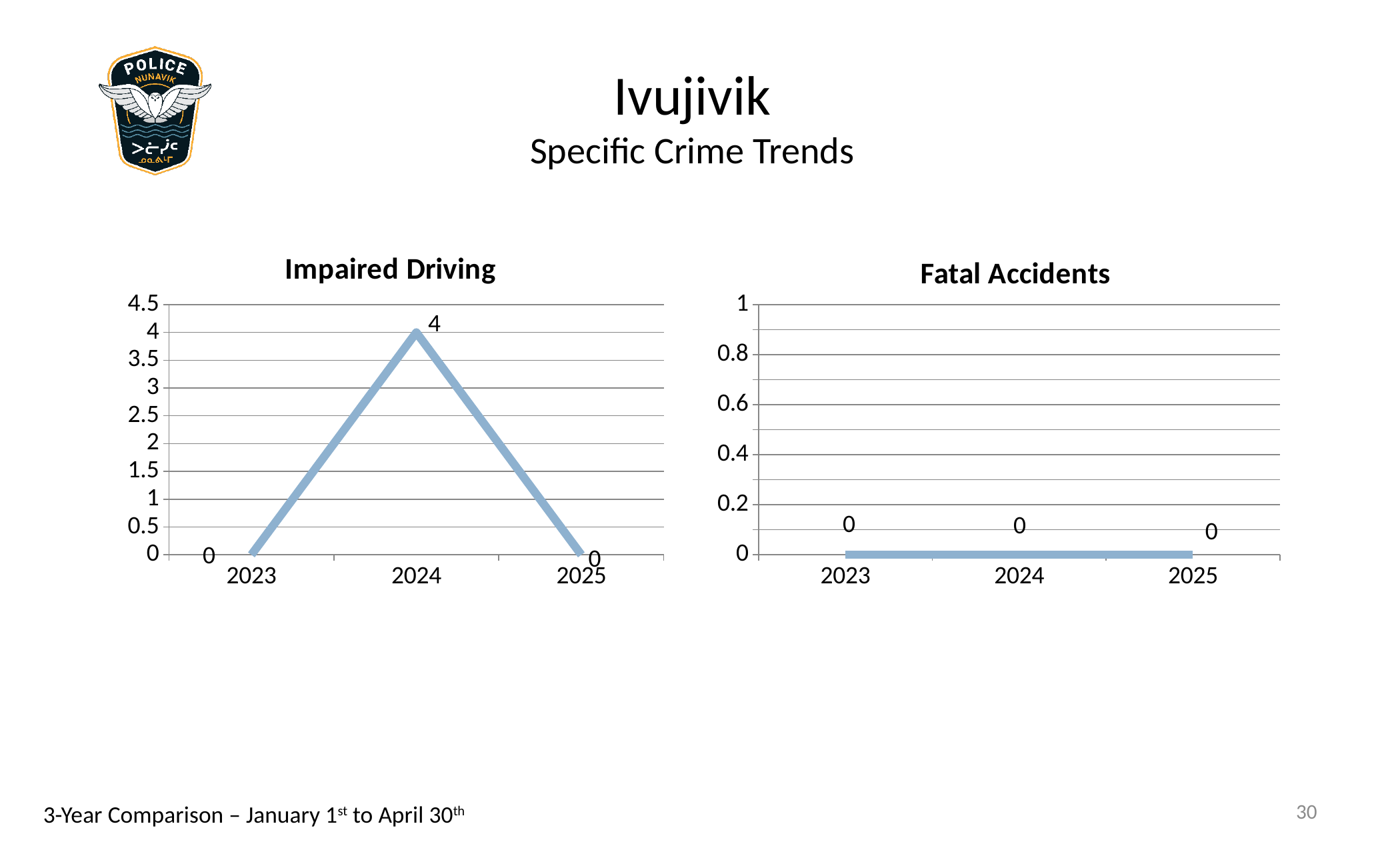
What kind of chart is the Impaired Driving chart? Line chart In the Impaired Driving chart, which year has the highest value? 2024 In the Fatal Accidents chart, do the values rise, fall, or stay flat from 2023 to 2025? Stay flat In the Impaired Driving chart, what is the value for 2025? 0 In the Impaired Driving chart, how many years are plotted? 3 In the Impaired Driving chart, what is the value for 2024? 4 In the Impaired Driving chart, is the value for 2024 greater or less than 3? greater In the Impaired Driving chart, what is the difference between the 2024 value and the 2023 value? 4 In the Fatal Accidents chart, what is the value for 2024? 0 What is the title of the chart on the right side of the slide? Fatal Accidents In the Impaired Driving chart, what is the value for 2023? 0 In the Impaired Driving chart, which is larger, the value for 2024 or the value for 2025? 2024